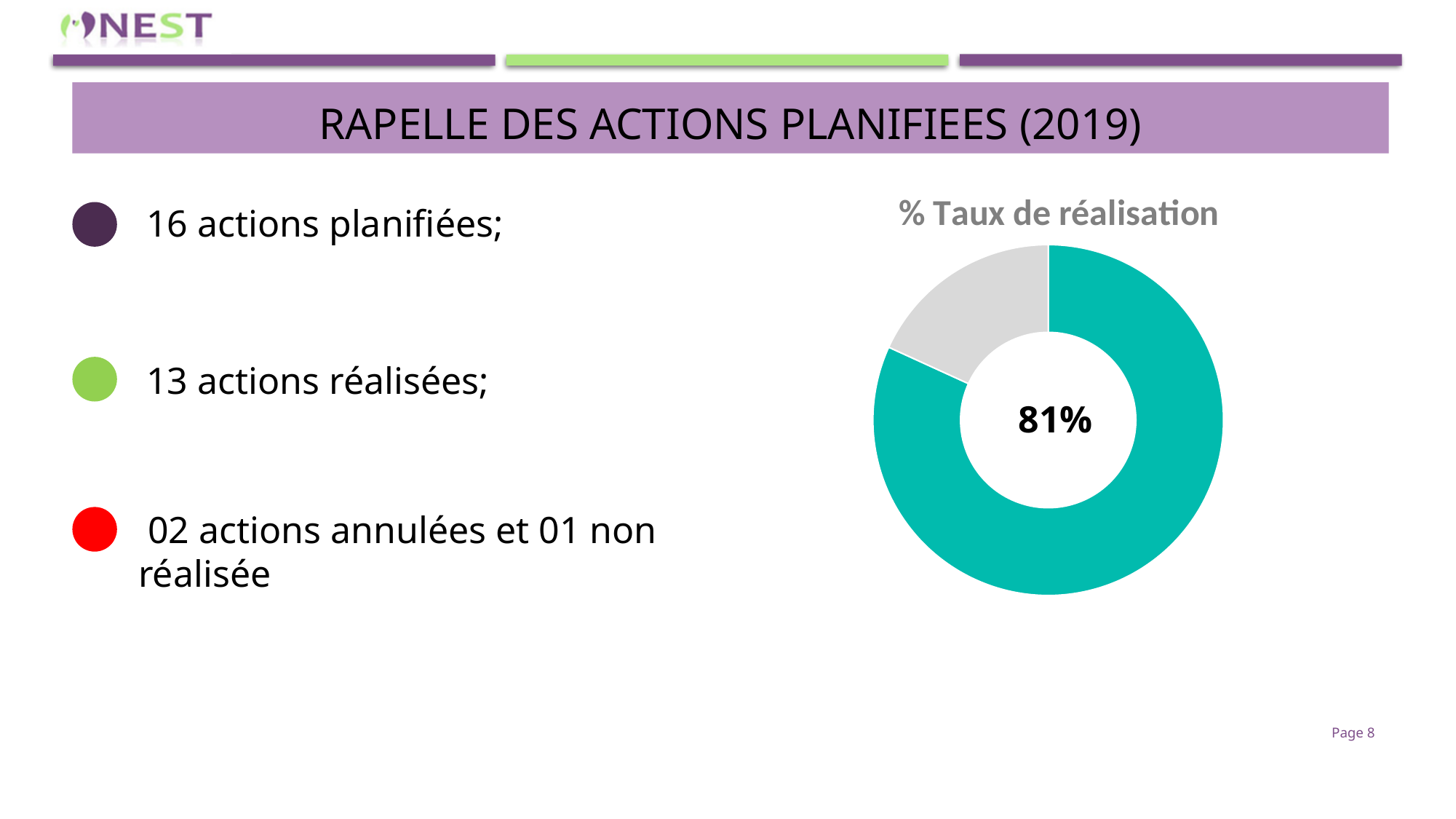
What colour is the largest slice of the doughnut chart? Teal Is the teal slice of the doughnut chart greater or less than 50% of the whole? greater Which slice of the doughnut chart is larger, the teal one or the grey one? The teal one What share of the doughnut chart does the teal slice represent? 81% Is the grey slice of the doughnut chart greater or less than 50% of the whole? less Which slice of the doughnut chart is the smallest? The grey slice What kind of chart is shown on the slide? Doughnut (pie) chart What is the title of the chart on the slide? % Taux de réalisation What value is printed in the centre of the doughnut chart? 81% How many slices does the doughnut chart have? 2